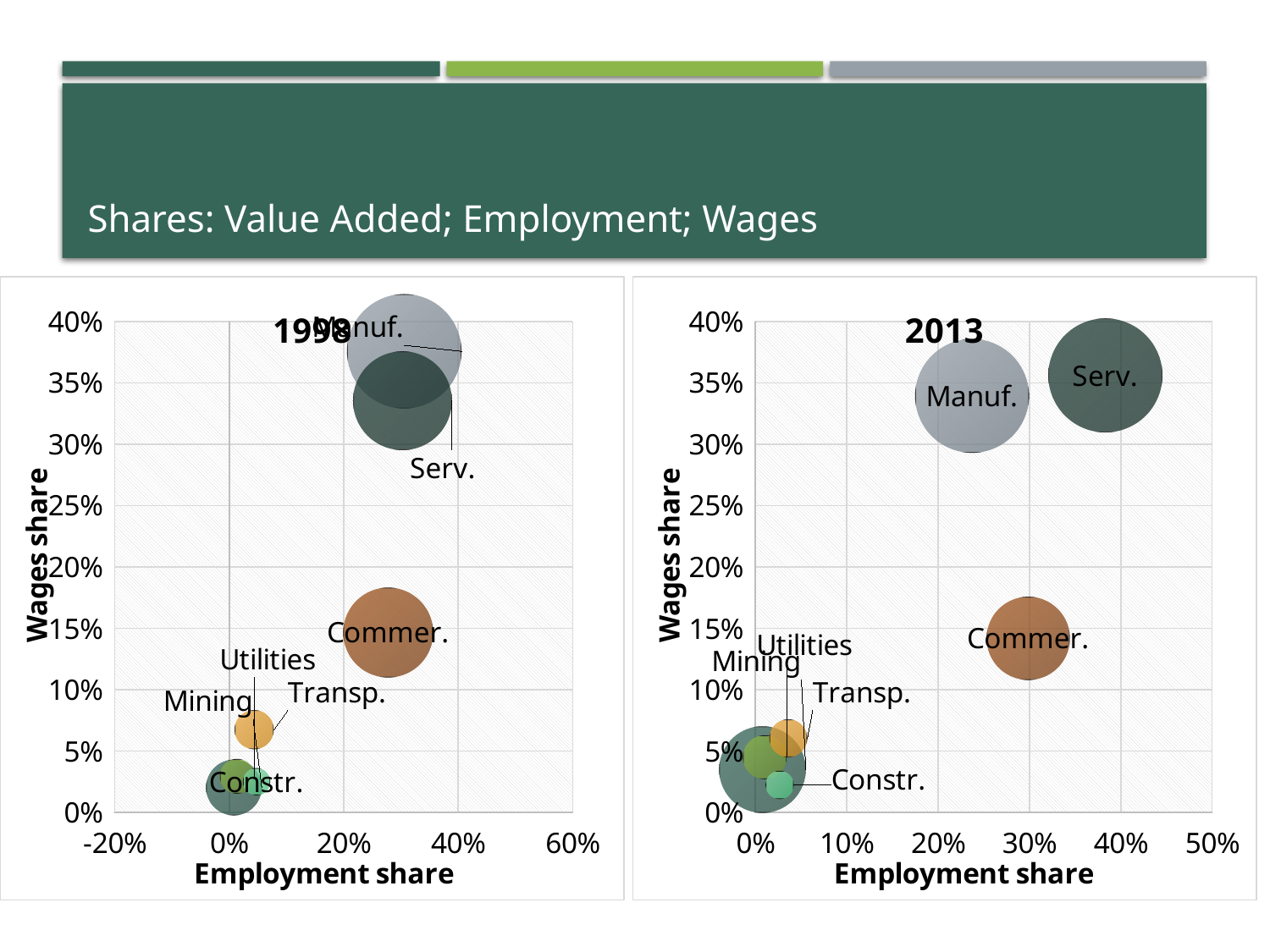
In the 2013 chart, is the wages share for Commer. greater or less than 20%? less In the 2013 chart, which has the larger employment share, Serv. or Manuf.? Serv. In the 2013 chart, is the wages share for Manuf. greater or less than 30%? greater What is the title of the vertical axis in the 1998 chart? Wages share In the 2013 chart, which sector has the highest employment share? Serv. In the 2013 chart, which has the larger wages share, Commer. or Transp.? Commer. In the 1998 chart, is the wages share for Transp. greater or less than 10%? less In the 1998 chart, which sector has the highest wages share? Manuf. How many sectors are labelled in the 2013 chart? 7 What kind of chart is the 1998 chart on the left? bubble chart